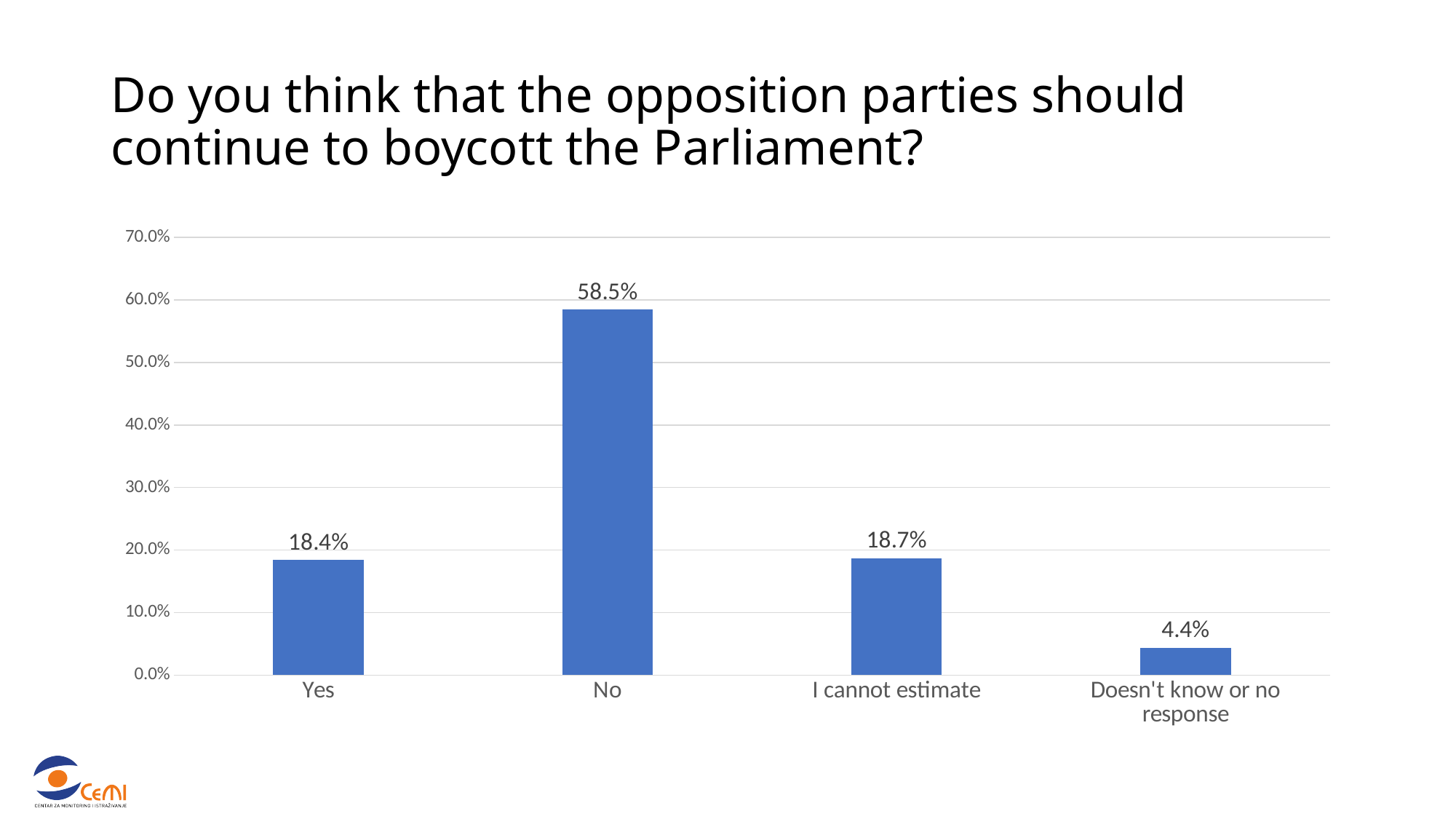
What is the value for "I cannot estimate"? 18.7% Which response category has the highest value? No Is the value for "No" greater or less than 50.0%? greater What kind of chart is shown on the slide? Bar chart Which is larger, the value for "No" or the value for "I cannot estimate"? No Which response category has the lowest value? Doesn't know or no response What percentage of respondents answered "No"? 58.5% How many response categories are shown on the chart? 4 What is the value for "Doesn't know or no response"? 4.4% What is the difference between the "No" and "Yes" values? 40.1% What is the difference between the "I cannot estimate" and "Doesn't know or no response" values? 14.3% What percentage of respondents answered "Yes"? 18.4%